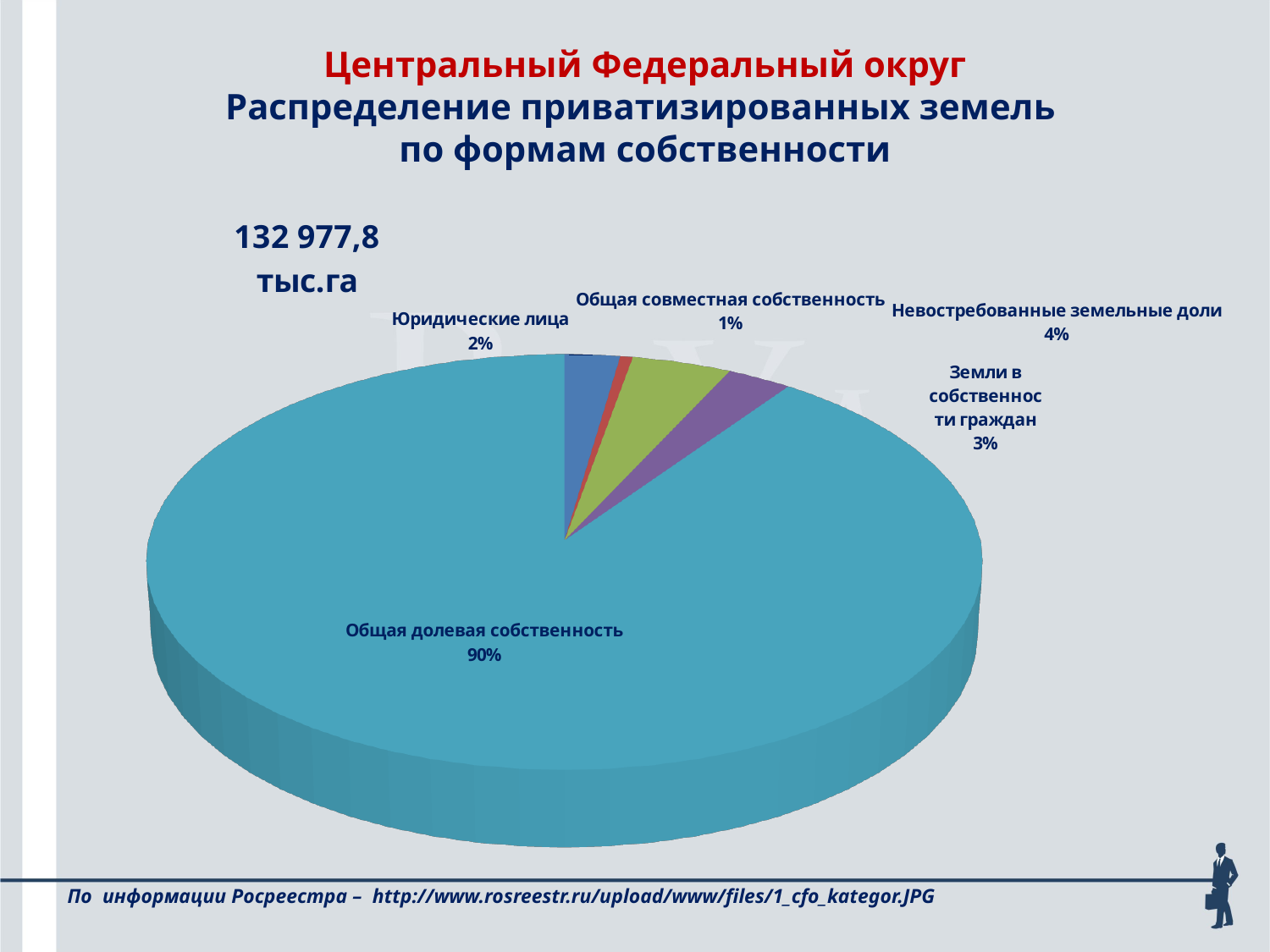
What total area in thousand hectares is stated next to the chart? 132 977,8 тыс.га What is the difference in percentage points between "Невостребованные земельные доли" and "Юридические лица"? 2% What kind of chart is shown on the slide? Pie chart What percentage is shown for "Невостребованные земельные доли"? 4% Which category has the largest slice of the pie? Общая долевая собственность How many slices does the pie chart have? 5 What percentage is shown for "Юридические лица"? 2% Which category has the smallest slice of the pie? Общая совместная собственность What percentage is shown for "Общая совместная собственность"? 1% What share of the pie does "Общая долевая собственность" hold? 90% Which is larger: the share for "Земли в собственности граждан" or the share for "Общая совместная собственность"? Земли в собственности граждан What percentage is shown for "Земли в собственности граждан"? 3%